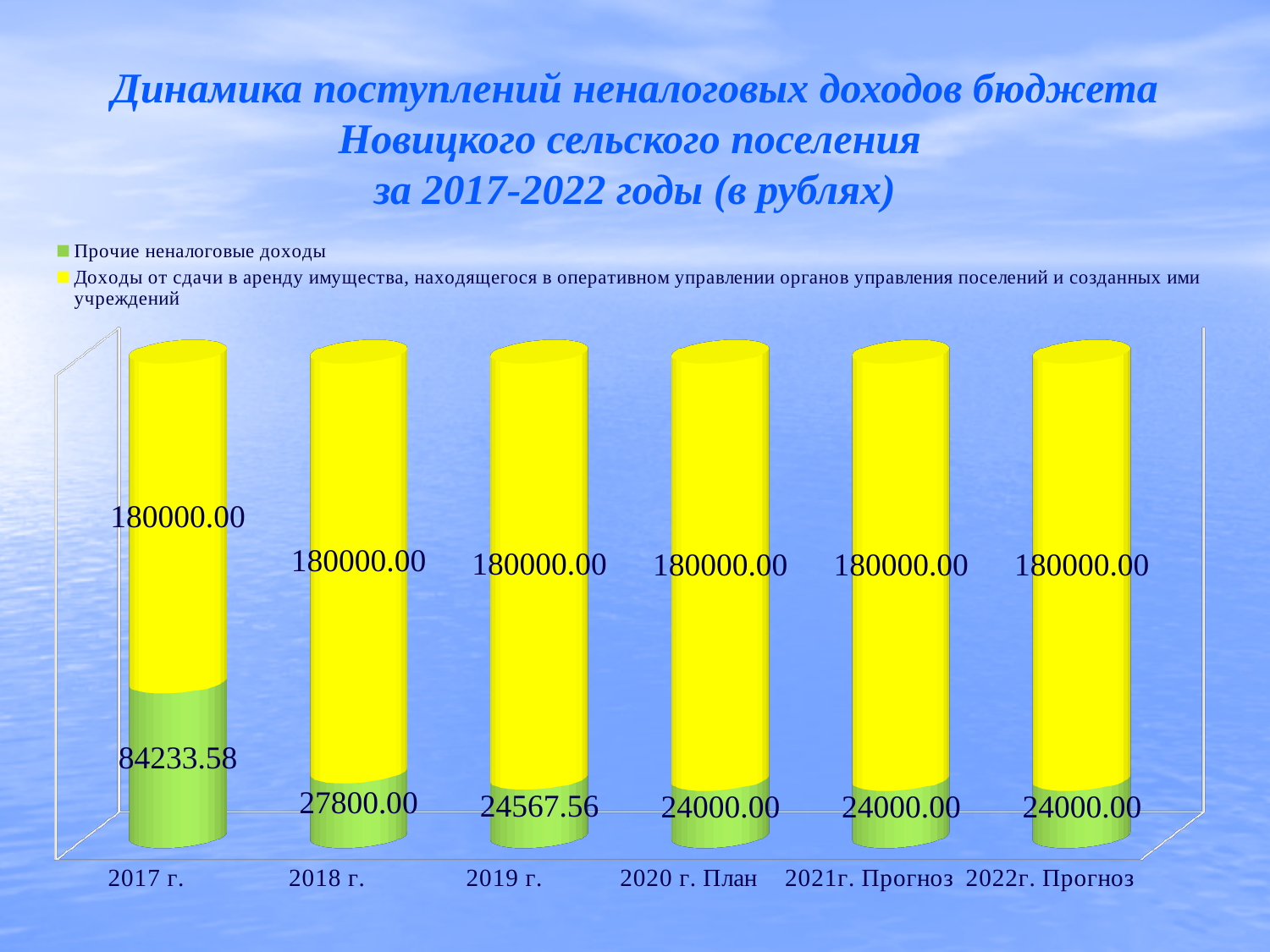
What is the value of Прочие неналоговые доходы for 2022г. Прогноз? 24000.00 How many series does the legend list? 2 What is the value of Доходы от сдачи в аренду имущества for 2020 г. План? 180000.00 How many categories are shown on the x axis? 6 What is the value of Прочие неналоговые доходы for 2019 г.? 24567.56 What is the difference between the Прочие неналоговые доходы values for 2017 г. and 2018 г.? 56433.58 What is the total of the stacked bar for 2018 г.? 207800.00 What kind of chart is shown on the slide? Stacked bar chart Which category has the highest value for Прочие неналоговые доходы? 2017 г. What is the value of Прочие неналоговые доходы for 2017 г.? 84233.58 Which is larger: Прочие неналоговые доходы for 2018 г. or for 2019 г.? 2018 г. Does the value of Прочие неналоговые доходы rise or fall from 2017 г. to 2020 г. План? Fall